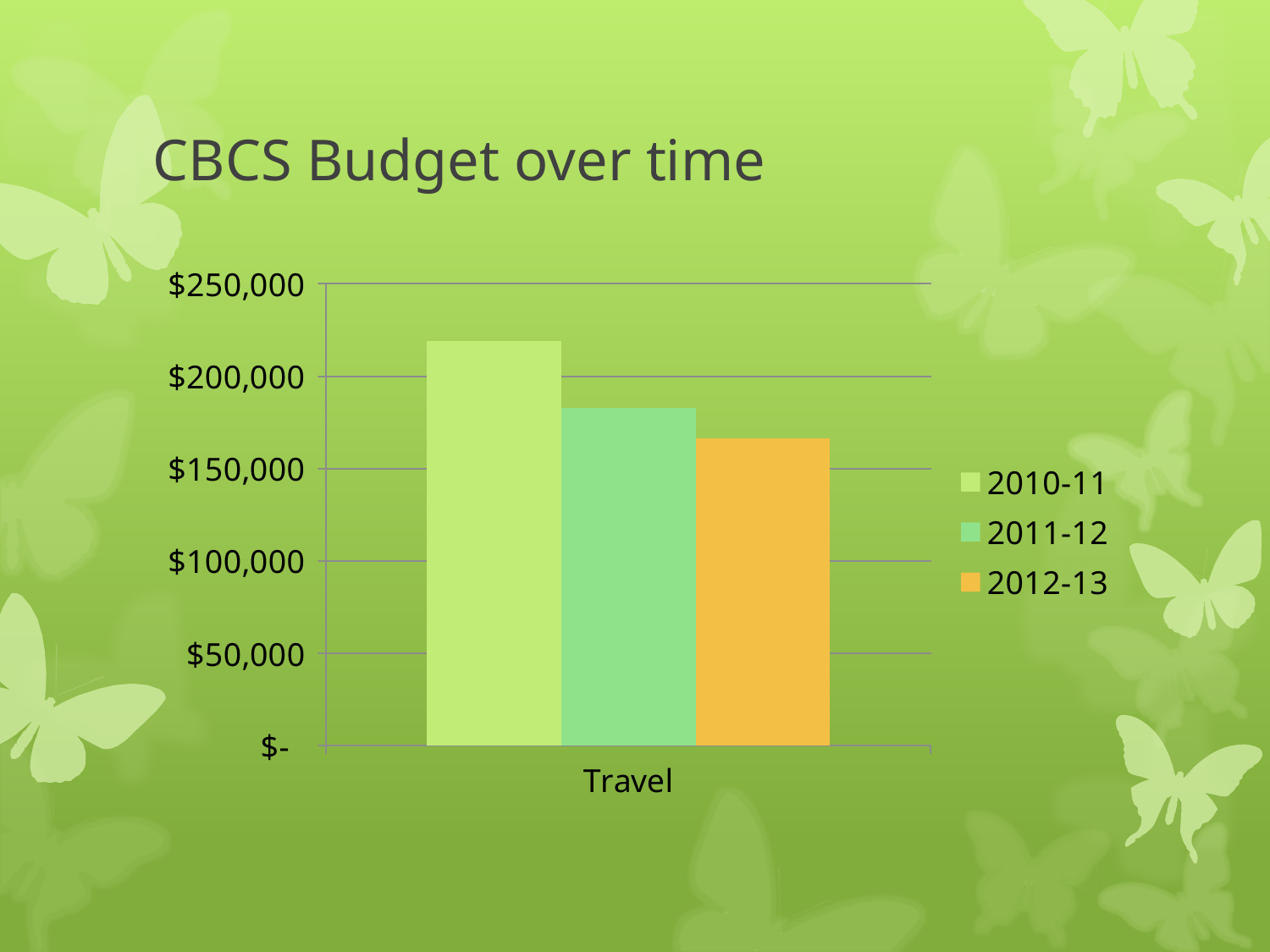
Is the Travel budget for 2011-12 greater or less than $200,000? less Which series is shown in orange? 2012-13 Which year has the lowest Travel budget? 2012-13 Is the Travel budget for 2010-11 greater or less than $200,000? greater How many categories are shown on the x axis? 1 What kind of chart is shown on the slide? bar chart Do the Travel budget values rise or fall from 2010-11 to 2012-13? fall Which year has the highest Travel budget? 2010-11 How many series does the legend list? 3 Which is larger, the Travel budget for 2011-12 or for 2012-13? 2011-12 Is the Travel budget for 2012-13 greater or less than $150,000? greater What is the title of the slide containing the chart? CBCS Budget over time